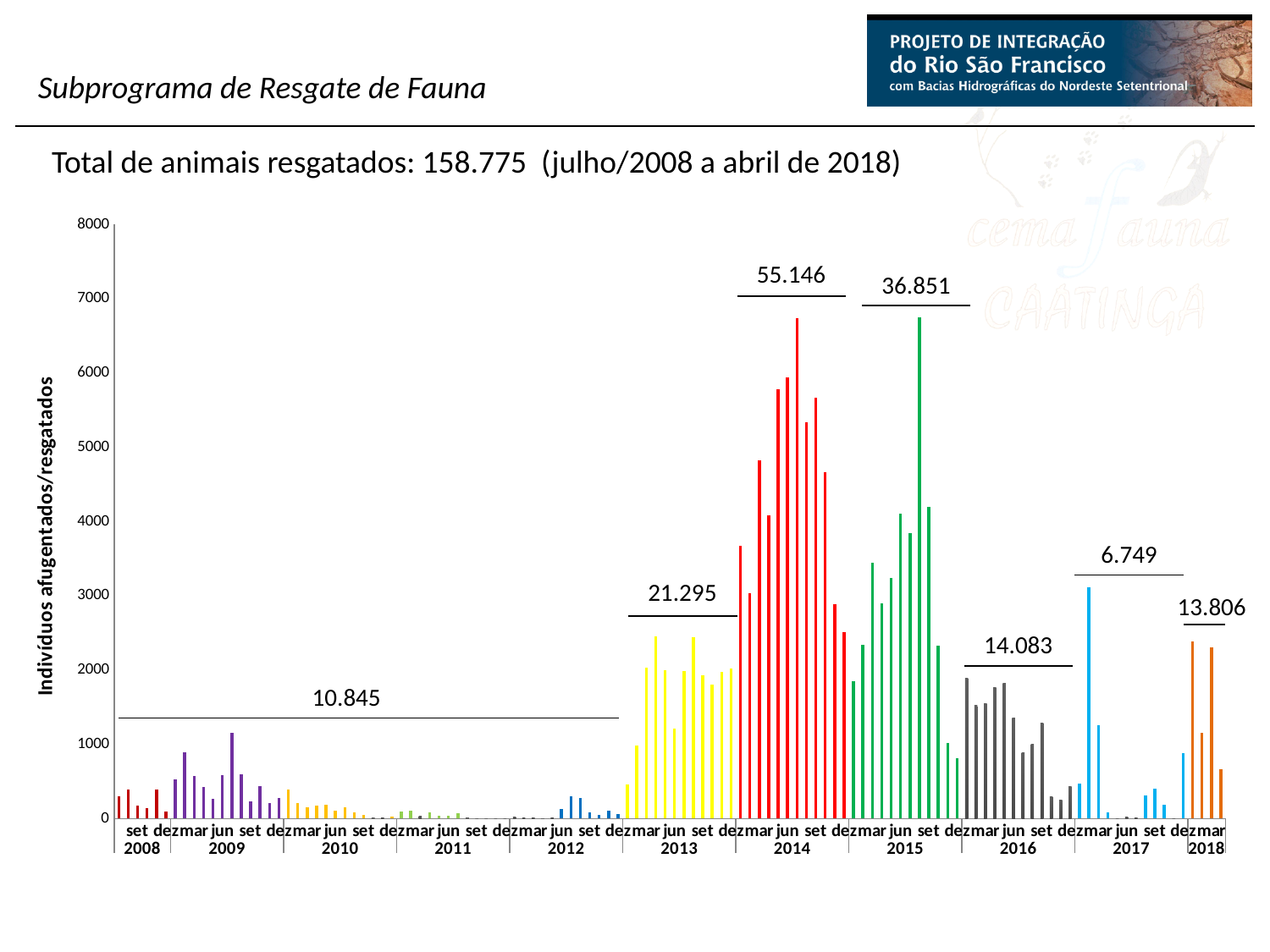
What total is annotated above the bars for 2017? 6.749 Which annotated total is larger, 2016 or 2018? 2016 What kind of chart is shown on the slide? bar chart Which single year has the lowest annotated total of rescued animals? 2017 What is the label of the vertical axis? Indivíduos afugentados/resgatados Which year has the highest annotated total of rescued animals? 2014 Is the value of the tallest bar in 2013 greater or less than 2000? greater What total is annotated above the bars for 2015? 36.851 What total is annotated above the bars for 2013? 21.295 What is the difference between the annotated totals for 2014 and 2015? 18.295 What total is annotated above the bars for 2014? 55.146 What total is annotated above the bars spanning 2008 to 2012? 10.845